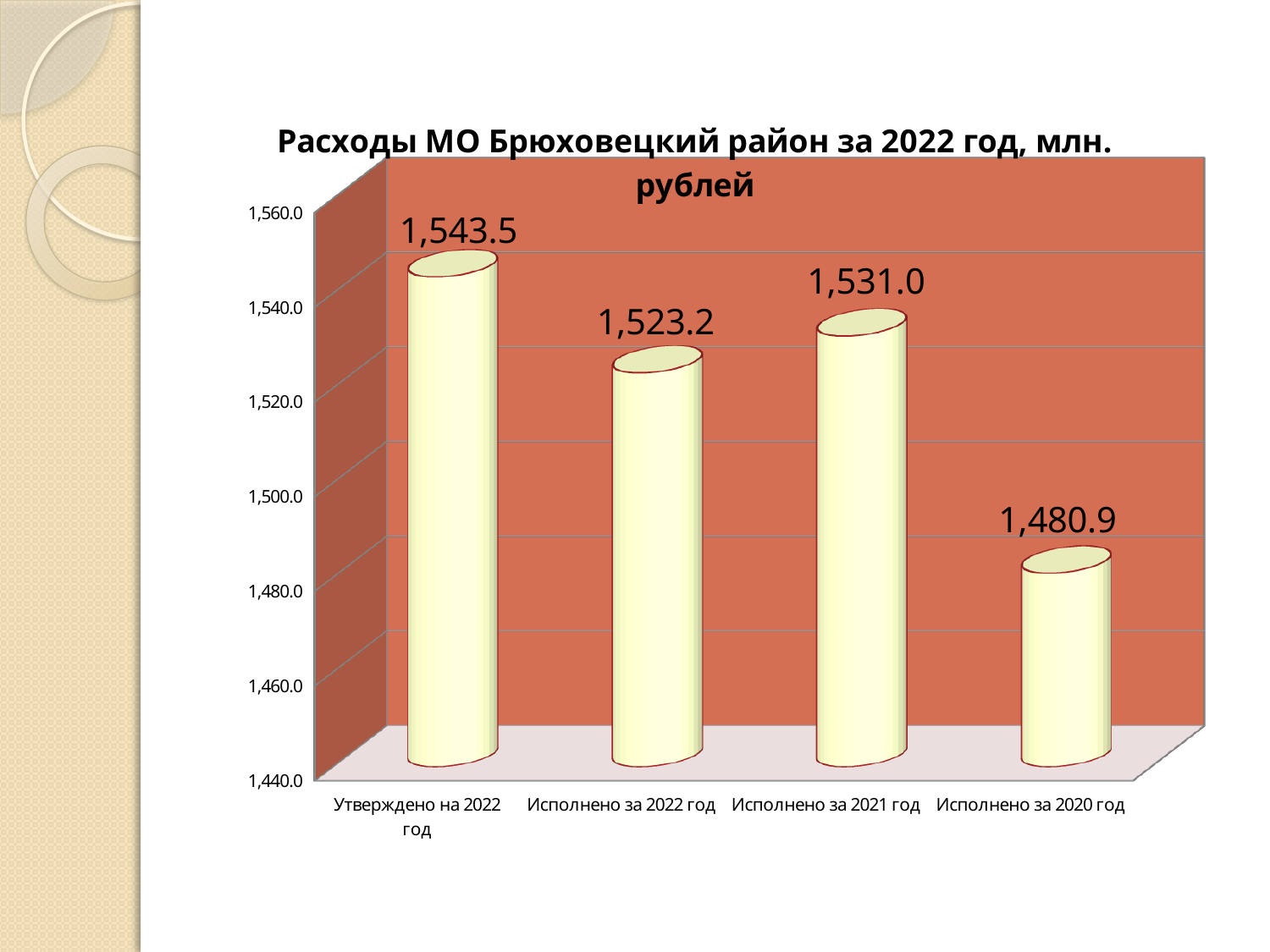
What kind of chart is shown on the slide? bar chart Is the value for Исполнено за 2020 год greater or less than 1,500.0? less What is the difference between Утверждено на 2022 год and Исполнено за 2022 год? 20.3 How many categories are shown in the chart? 4 Which category has the lowest value? Исполнено за 2020 год What is the value for Исполнено за 2021 год? 1,531.0 Which category has the highest value? Утверждено на 2022 год What is the difference between Исполнено за 2021 год and Исполнено за 2020 год? 50.1 Which is larger, Исполнено за 2022 год or Исполнено за 2021 год? Исполнено за 2021 год What is the value for Исполнено за 2022 год? 1,523.2 What is the value for Утверждено на 2022 год? 1,543.5 What is the value for Исполнено за 2020 год? 1,480.9